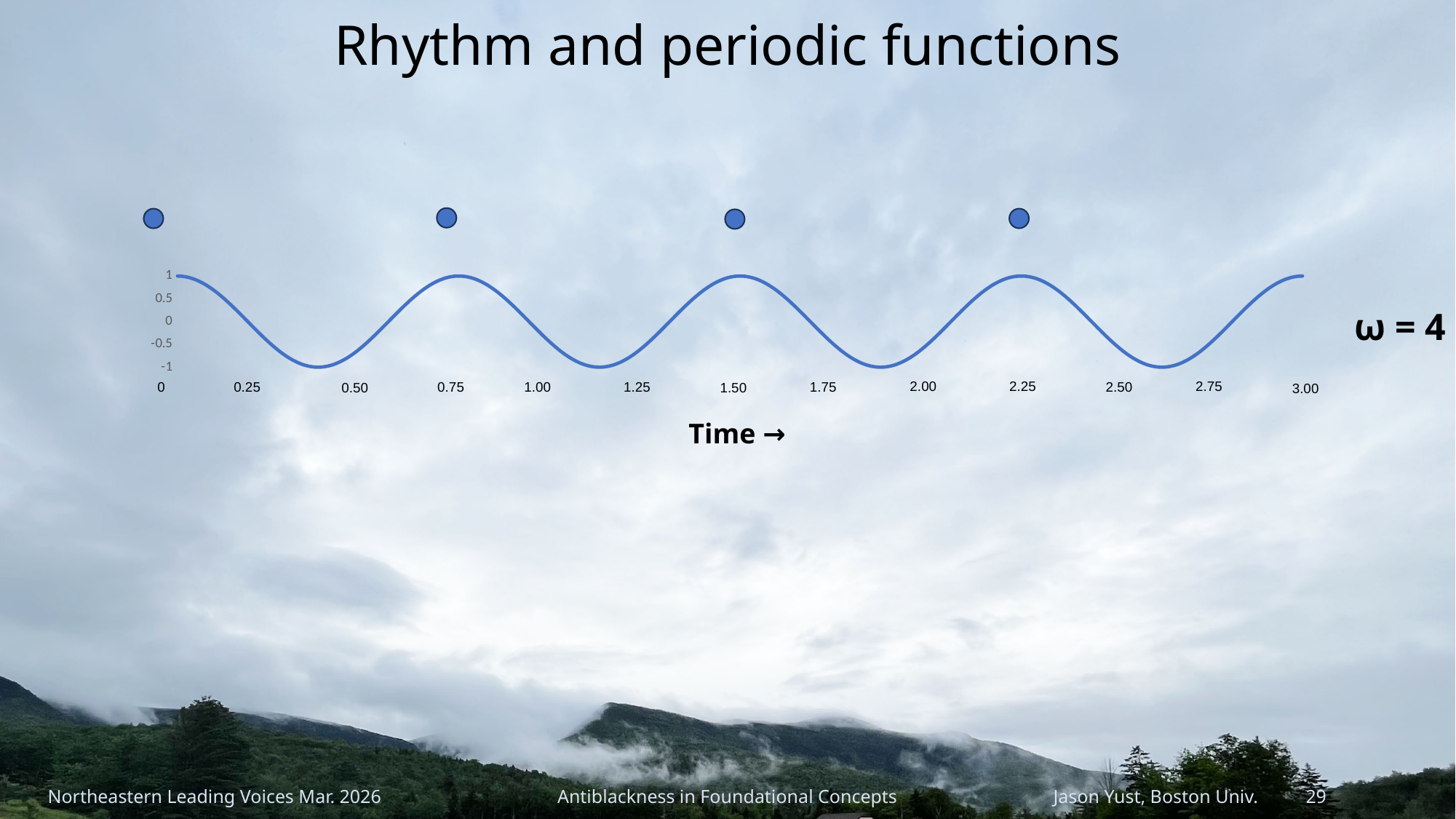
What is the label on the x axis of the chart? Time → Is the value of the curve at time 0.50 greater or less than 0? less What is the largest tick value shown on the x axis? 3.00 Is the value of the curve at time 1.25 greater or less than 0? less How many blue dots are drawn above the curve? 4 Does the curve rise or fall between time 0 and time 0.25? fall How many tick labels are shown on the x axis? 13 What is the value of the curve at time 0.75? 1 What kind of chart is shown on the slide? line chart What is the lowest tick value shown on the y axis? -1 What is the highest tick value shown on the y axis? 1 What is the value of the curve at time 0? 1